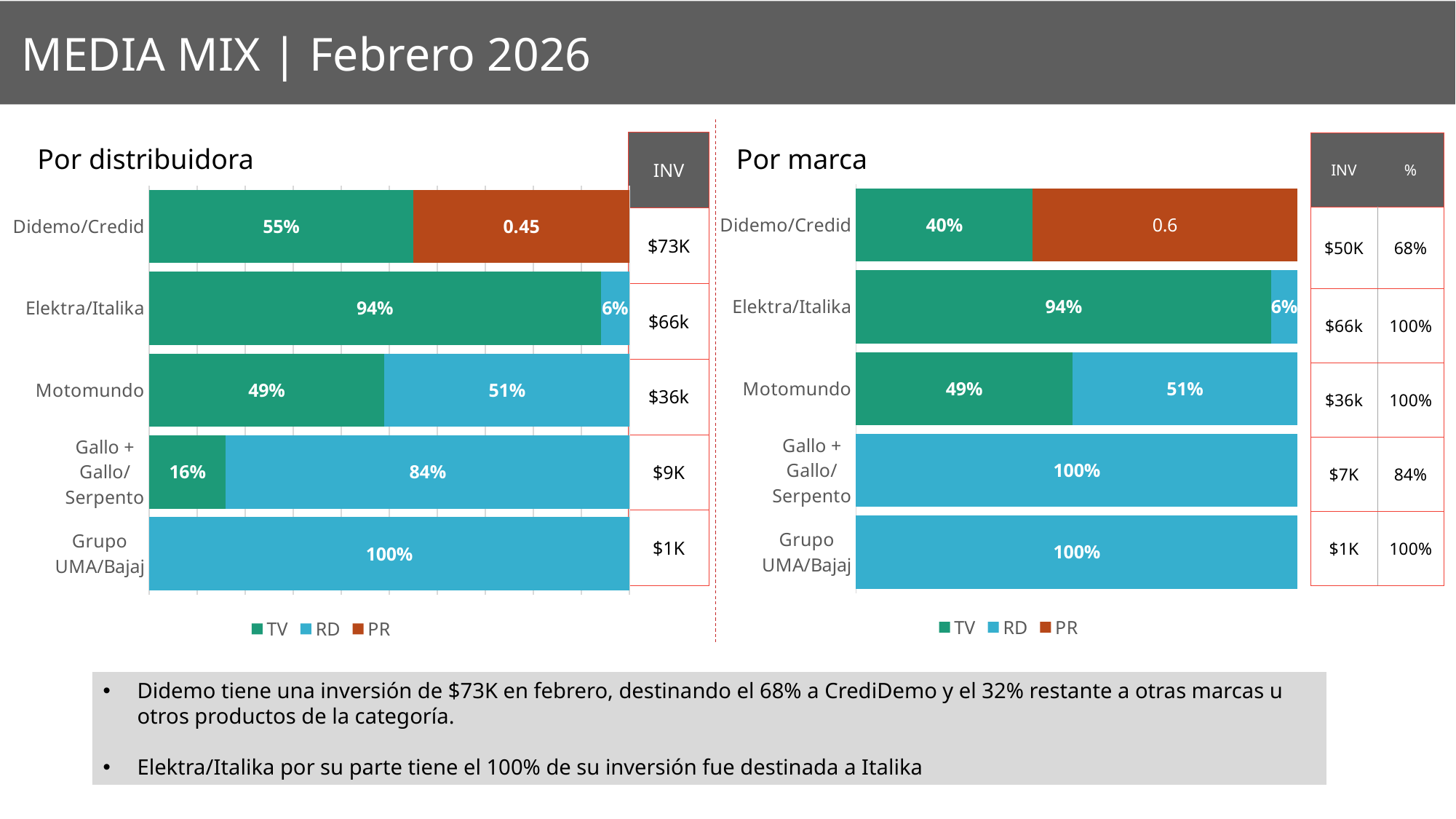
In the 'Por distribuidora' chart, what is the RD share for Gallo + Gallo/Serpento? 84% What type of chart is the 'Por marca' chart? Stacked bar chart In the 'Por distribuidora' chart, which category has the highest TV share? Elektra/Italika In the 'Por marca' chart, what is the TV share for Didemo/Credid? 40% How many series does the legend of the 'Por distribuidora' chart list? 3 In the 'Por distribuidora' chart, what is the TV share for Didemo/Credid? 55% In the 'Por marca' chart, what is the difference between the RD share and the TV share for Motomundo? 2% How many categories are shown in the 'Por marca' chart? 5 In the 'Por distribuidora' chart, which series is shown in orange-brown? PR In the 'Por marca' chart, what is the RD share for Gallo + Gallo/Serpento? 100% In the 'Por distribuidora' chart, what is the RD share for Elektra/Italika? 6% In the 'Por distribuidora' chart, which is larger for Motomundo: the TV share or the RD share? RD